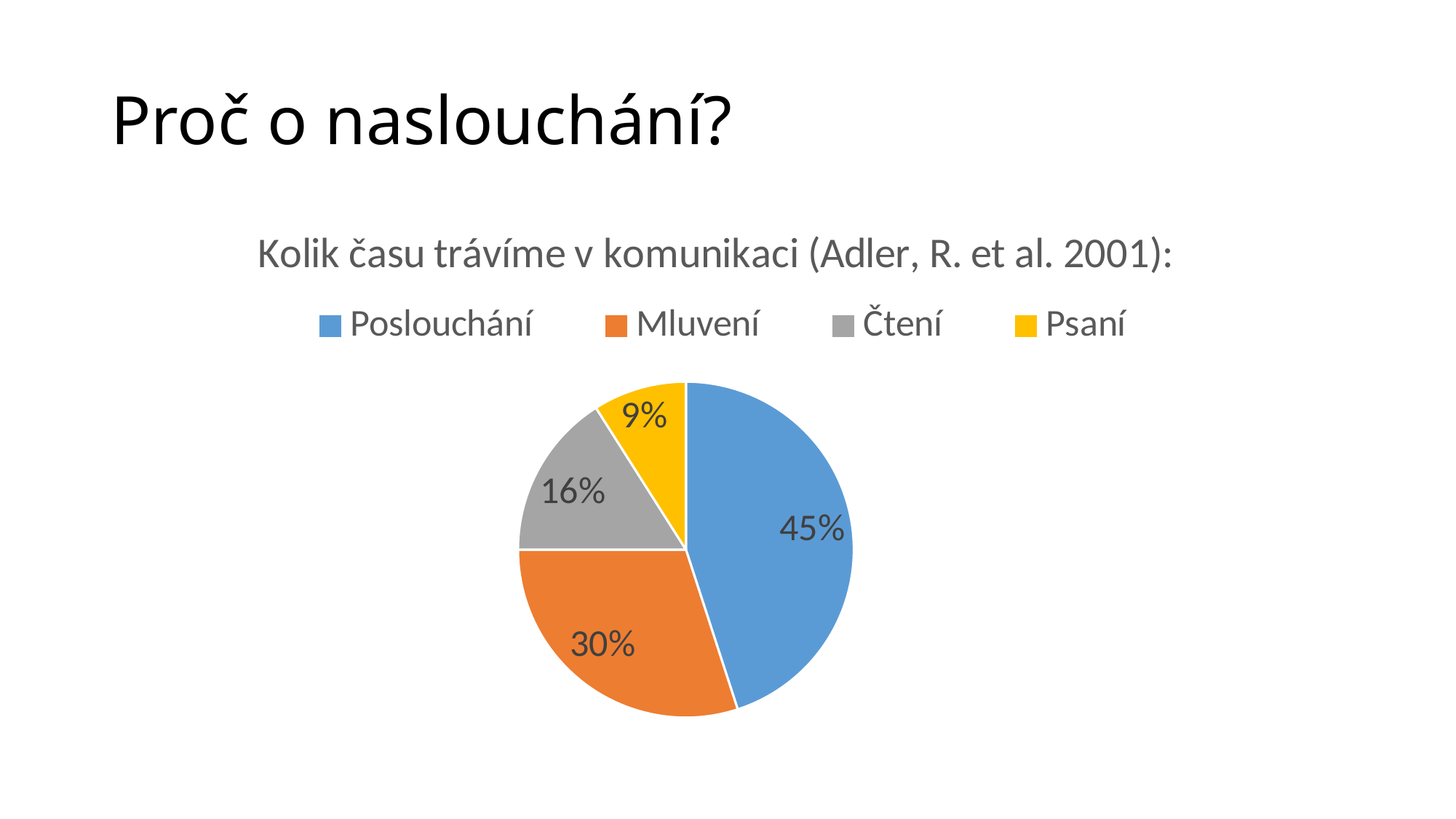
Which is larger, the value for Čtení or the value for Psaní? Čtení What is the value for Čtení? 16% How many slices does the pie chart have? 4 What is the value for Psaní? 9% What is the value for Poslouchání? 45% What kind of chart is shown on the slide? pie chart What is the value for Mluvení? 30% Which category has the largest share of the pie? Poslouchání What is the title of the chart? Kolik času trávíme v komunikaci (Adler, R. et al. 2001): What is the difference between the values for Poslouchání and Mluvení? 15% Which colour represents Mluvení in the chart? orange Which category has the smallest share of the pie? Psaní